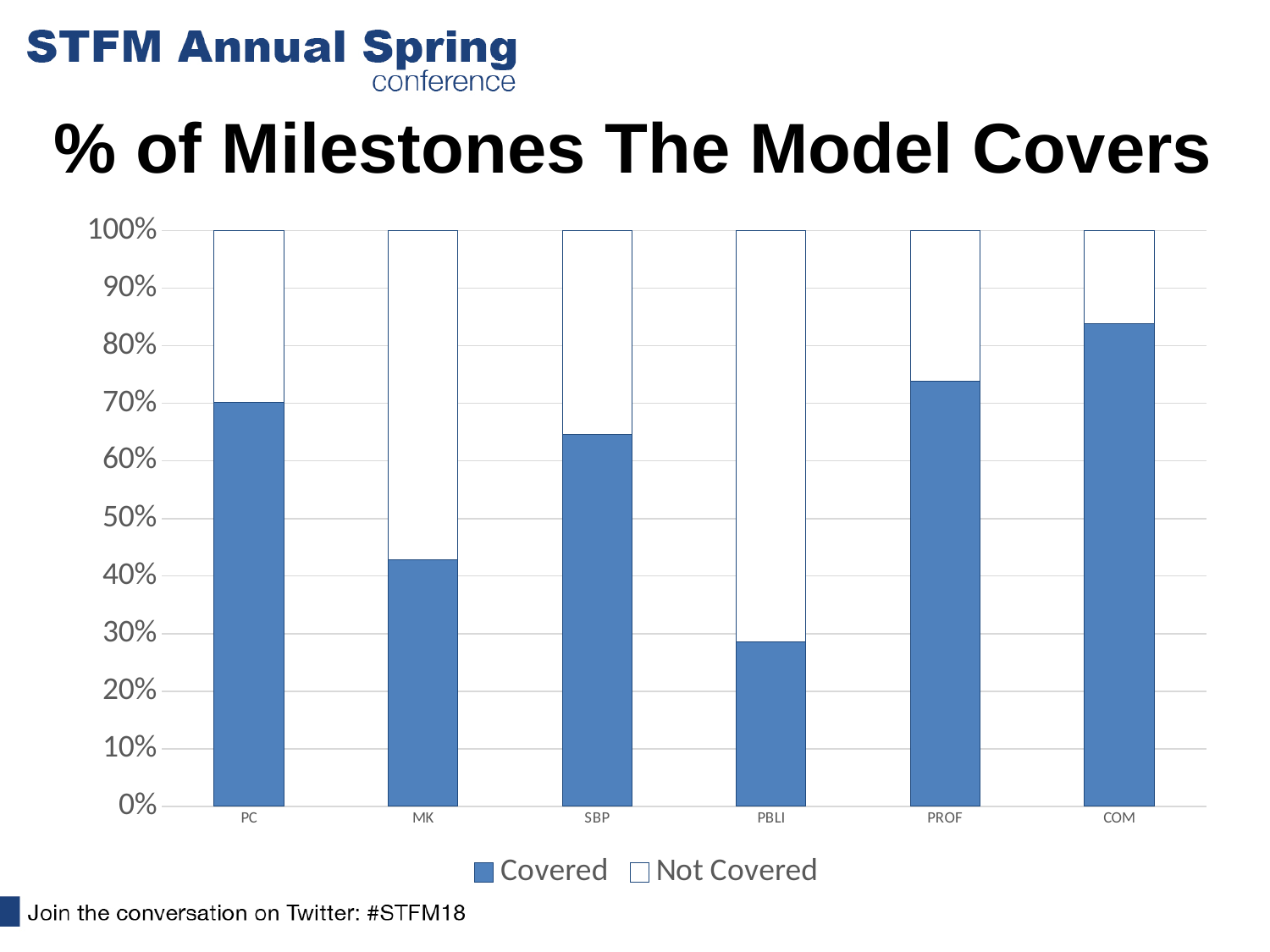
Is the Covered value for PC greater or less than 60%? greater What is the total height of the stacked bar for PC? 100% Is the Covered value for PBLI greater or less than 40%? less How many categories are shown on the x axis? 6 Which has a larger Covered value, PROF or SBP? PROF Which category has the lowest Covered value? PBLI Is the Covered value for COM greater or less than 80%? greater What kind of chart is shown on the slide? Stacked bar chart How many series does the legend list? 2 Which category has the highest Covered value? COM What is the title of the chart? % of Milestones The Model Covers